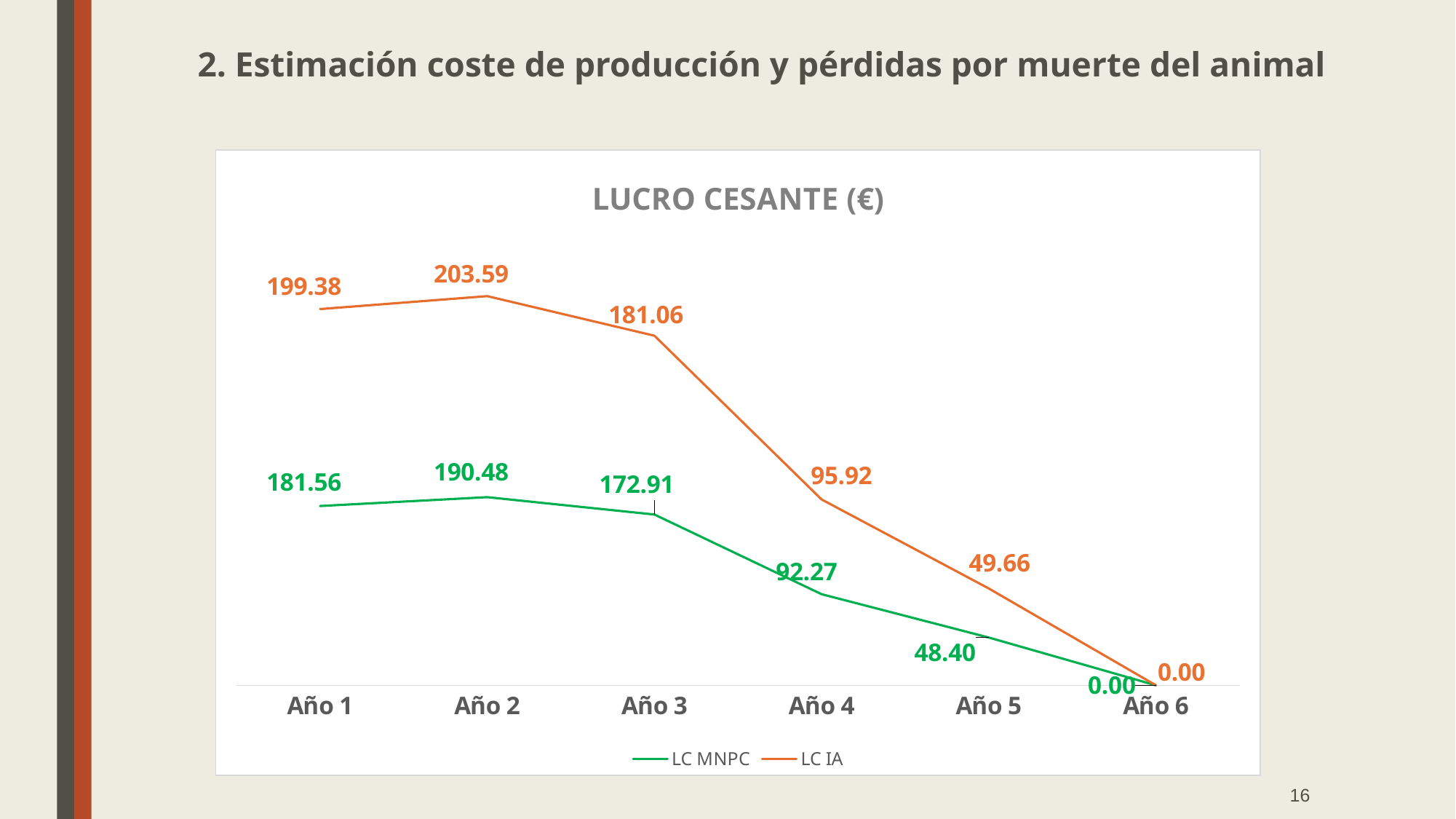
What is the value of LC IA in Año 2? 203.59 What is the value of LC MNPC in Año 4? 92.27 Which series has the larger value in Año 4, LC IA or LC MNPC? LC IA How many series does the legend list? 2 What is the difference between LC IA and LC MNPC in Año 1? 17.82 What kind of chart is shown on the slide? Line chart What is the value of LC MNPC in Año 3? 172.91 What is the value of LC IA in Año 5? 49.66 In which year does LC MNPC reach its lowest value? Año 6 How many years are shown on the x axis? 6 What is the title of the chart? LUCRO CESANTE (€) In which year does LC IA reach its highest value? Año 2